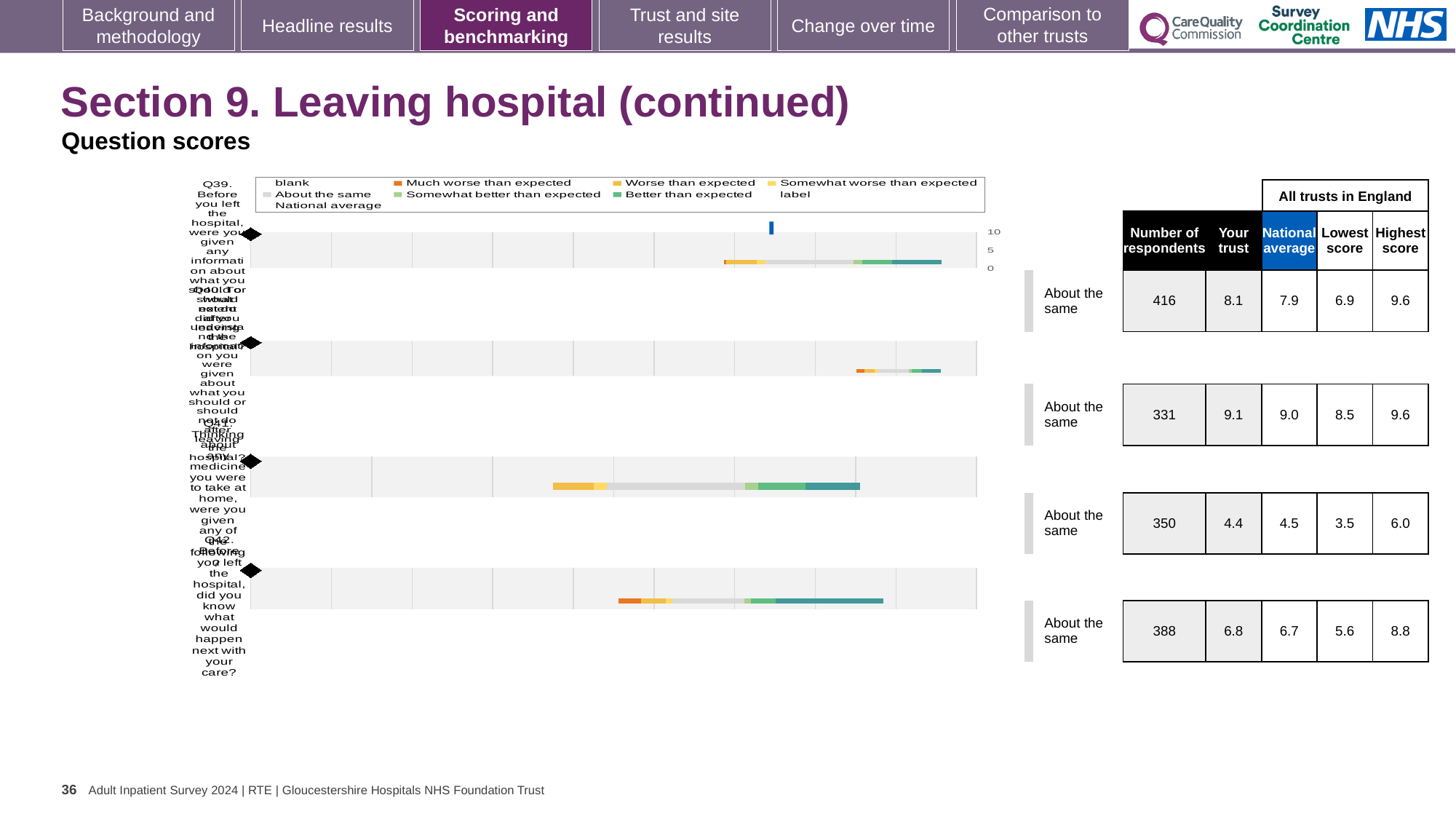
In the table beside the chart, what is the highest score for the fourth question (Q42)? 8.8 In the table beside the chart, what is the 'Your trust' score for the first question (Q39)? 8.1 How many entries does the chart legend list? 9 In the table beside the chart, is the 'Your trust' score for Q42 larger or smaller than the national average for Q42? larger Which colour does the legend use for 'Much worse than expected'? orange What kind of chart is shown on the slide? bar chart How many question bars are plotted in the chart? 4 In the table beside the chart, what is the number of respondents for the second question (Q40)? 331 In the table beside the chart, which question has the lowest 'Your trust' score? Q41 In the table beside the chart, what is the national average for the third question (Q41)? 4.5 What is the highest tick value shown on the chart's axis? 10 In the table beside the chart, what is the difference between the highest score and lowest score for Q39? 2.7